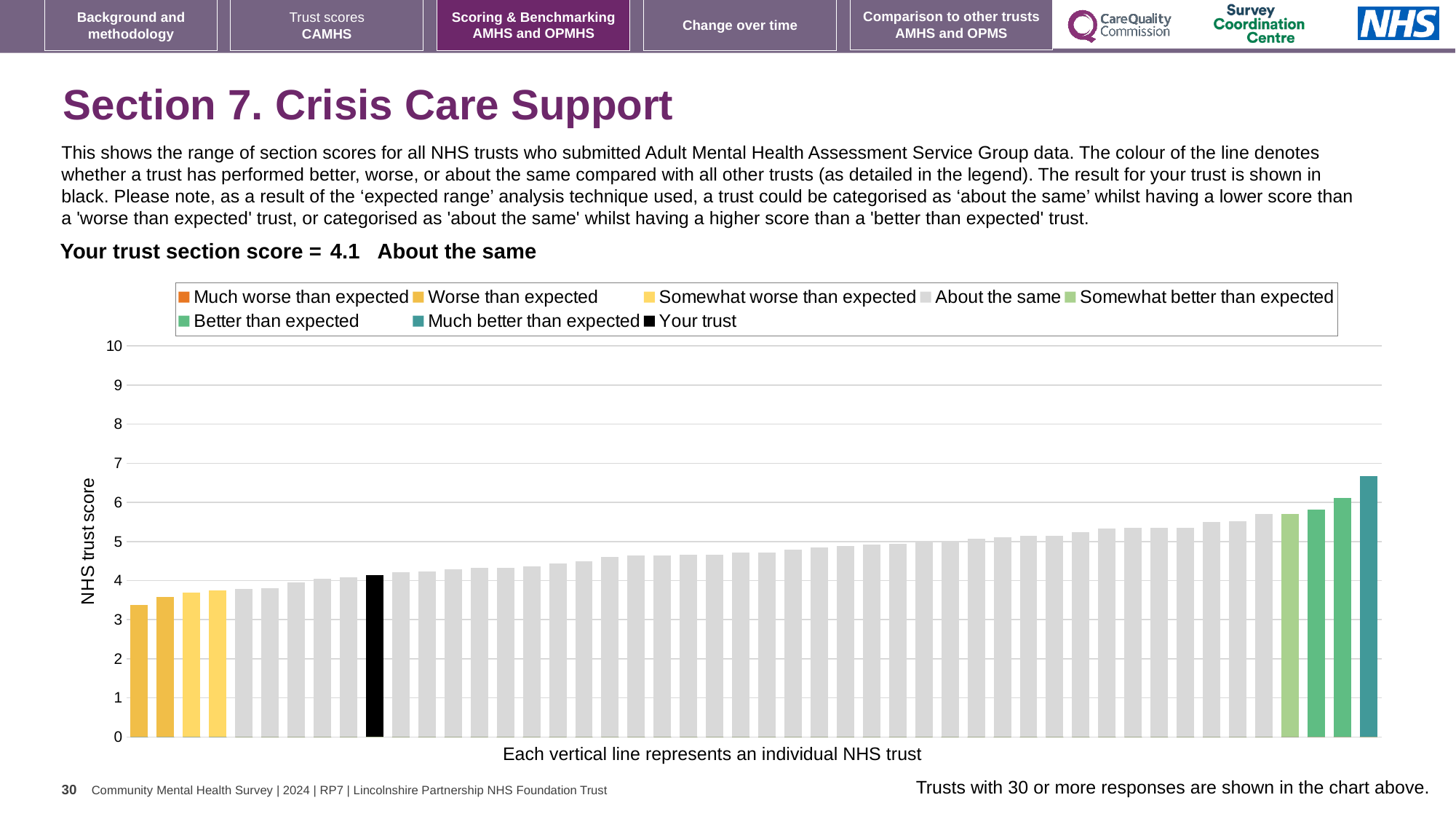
Is the value of the tallest bar in the chart greater or less than 6? greater What kind of chart is shown on the slide? bar chart What is the label on the vertical axis of the chart? NHS trust score Which category is 'Your trust' placed in according to the slide? About the same Is the value of the 'Your trust' bar greater or less than 5? less How many bars are coloured as 'Much better than expected'? 1 How many entries does the chart legend list? 8 Which legend category does the shortest bar in the chart belong to? Worse than expected What is the section score for 'Your trust' shown on the slide? 4.1 Which legend category does the tallest bar in the chart belong to? Much better than expected Do the bar values rise or fall from left to right along the x axis? rise Is the value of the shortest bar in the chart greater or less than 4? less